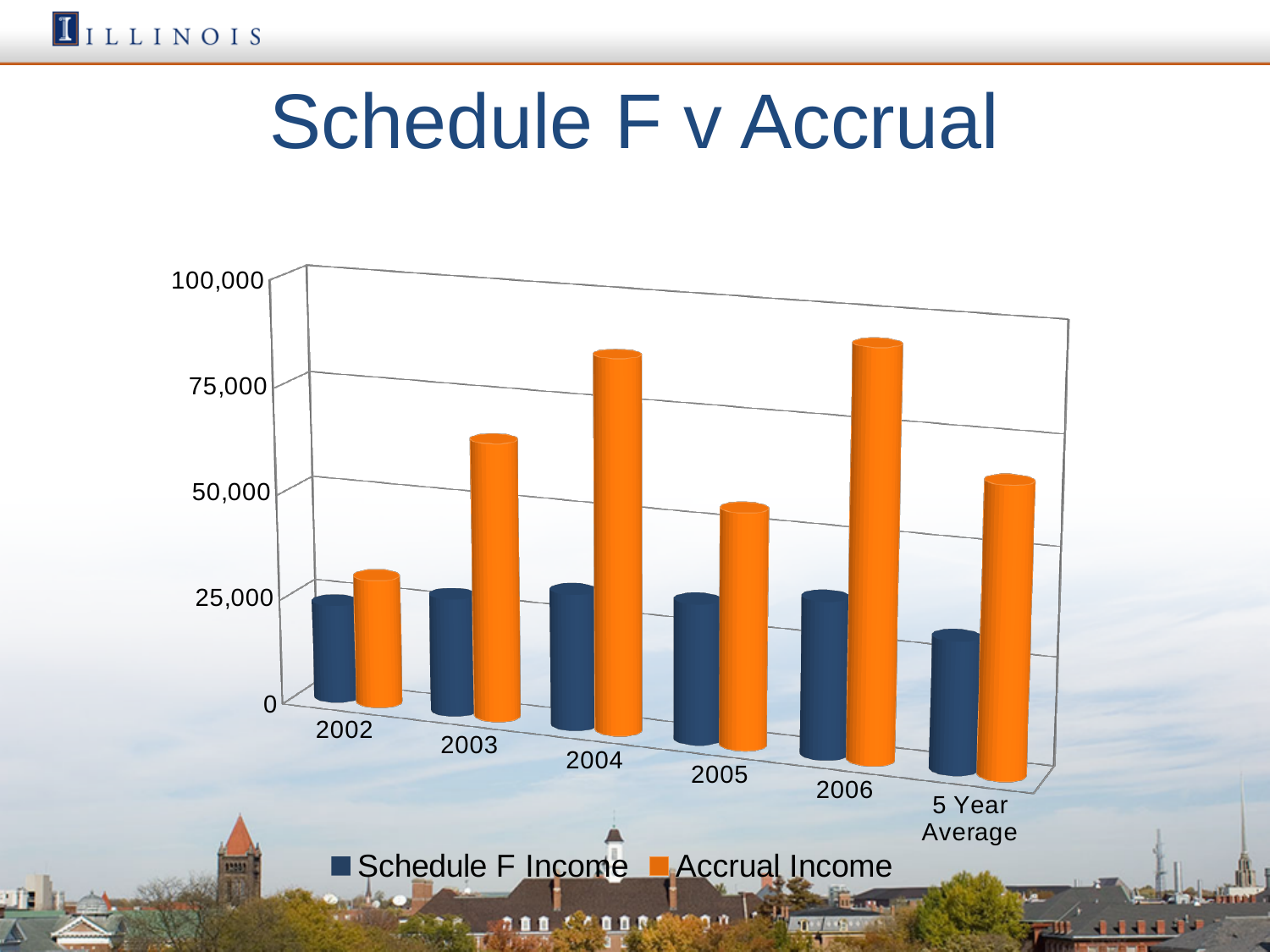
What kind of chart is shown on the slide? Bar chart Which is larger in 2006, Schedule F Income or Accrual Income? Accrual Income Does Accrual Income rise or fall from 2002 to 2004? Rise Is the Accrual Income for 2005 greater or less than 50,000? greater Which category has the lowest Schedule F Income? 2002 Which category has the lowest Accrual Income? 2002 Is the Accrual Income for 2004 greater or less than 75,000? greater What is the title of the chart? Schedule F v Accrual How many categories are shown on the x axis? 6 Which colour represents Accrual Income in the chart? Orange Is the Schedule F Income for the 5 Year Average greater or less than 25,000? greater How many series does the legend list? 2